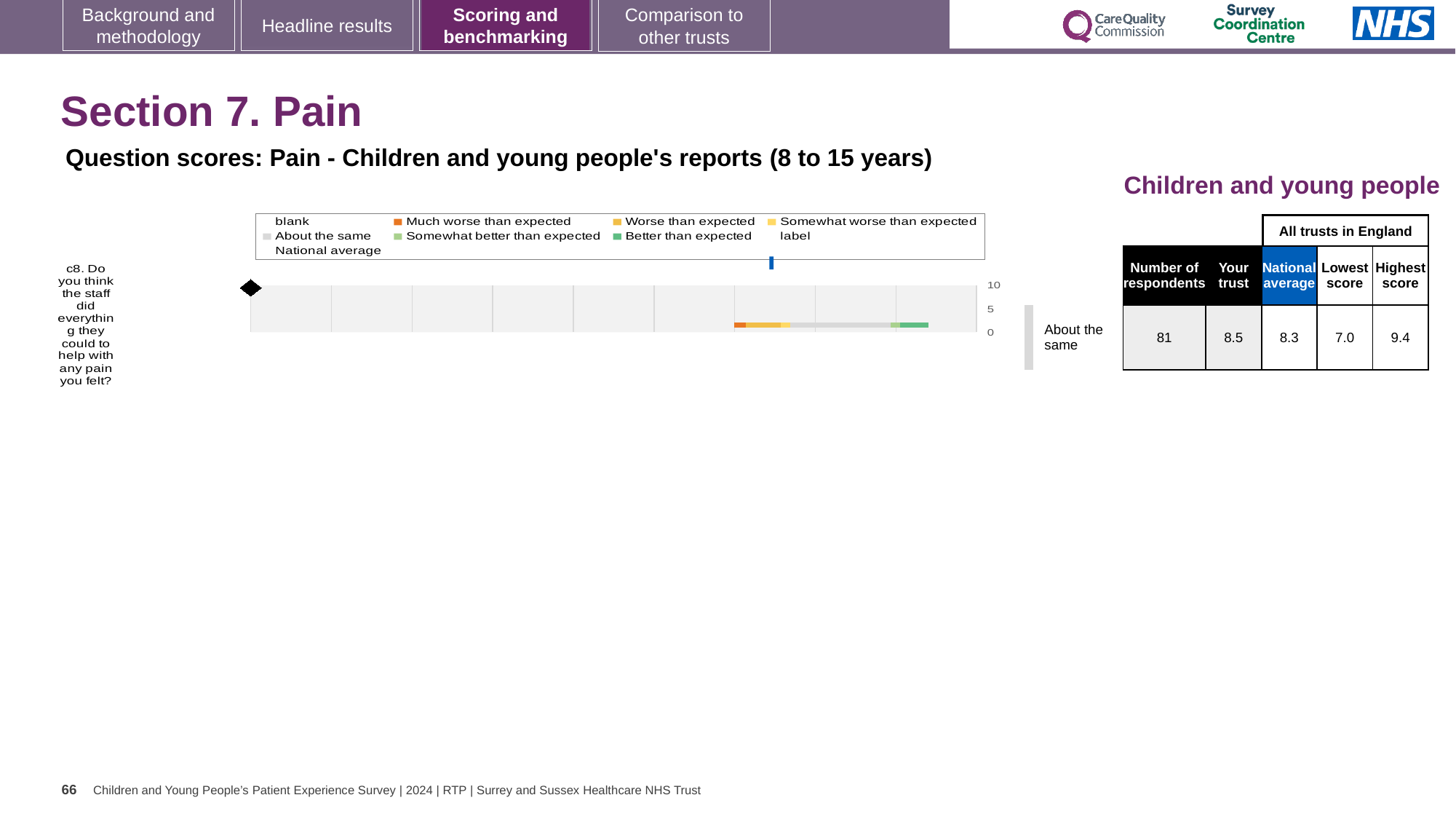
What is the highest value shown on the chart's axis? 10 What kind of chart is shown on the slide? Bar chart What is the difference between the Highest score and the Lowest score for question c8 in the table? 2.4 Which benchmarking category is the trust's result for question c8 labelled as on the chart? About the same In the table next to the chart, what is the 'Your trust' score for question c8? 8.5 In the table next to the chart, what is the Highest score among all trusts in England for question c8? 9.4 In the table next to the chart, what is the Lowest score among all trusts in England for question c8? 7.0 How many survey questions are plotted on the chart? 1 In the table next to the chart, what is the National average score for question c8? 8.3 In the table next to the chart, how many respondents answered question c8? 81 Is the 'Your trust' score for question c8 greater or less than 5? greater Which is larger for question c8: the 'Your trust' score or the National average? Your trust